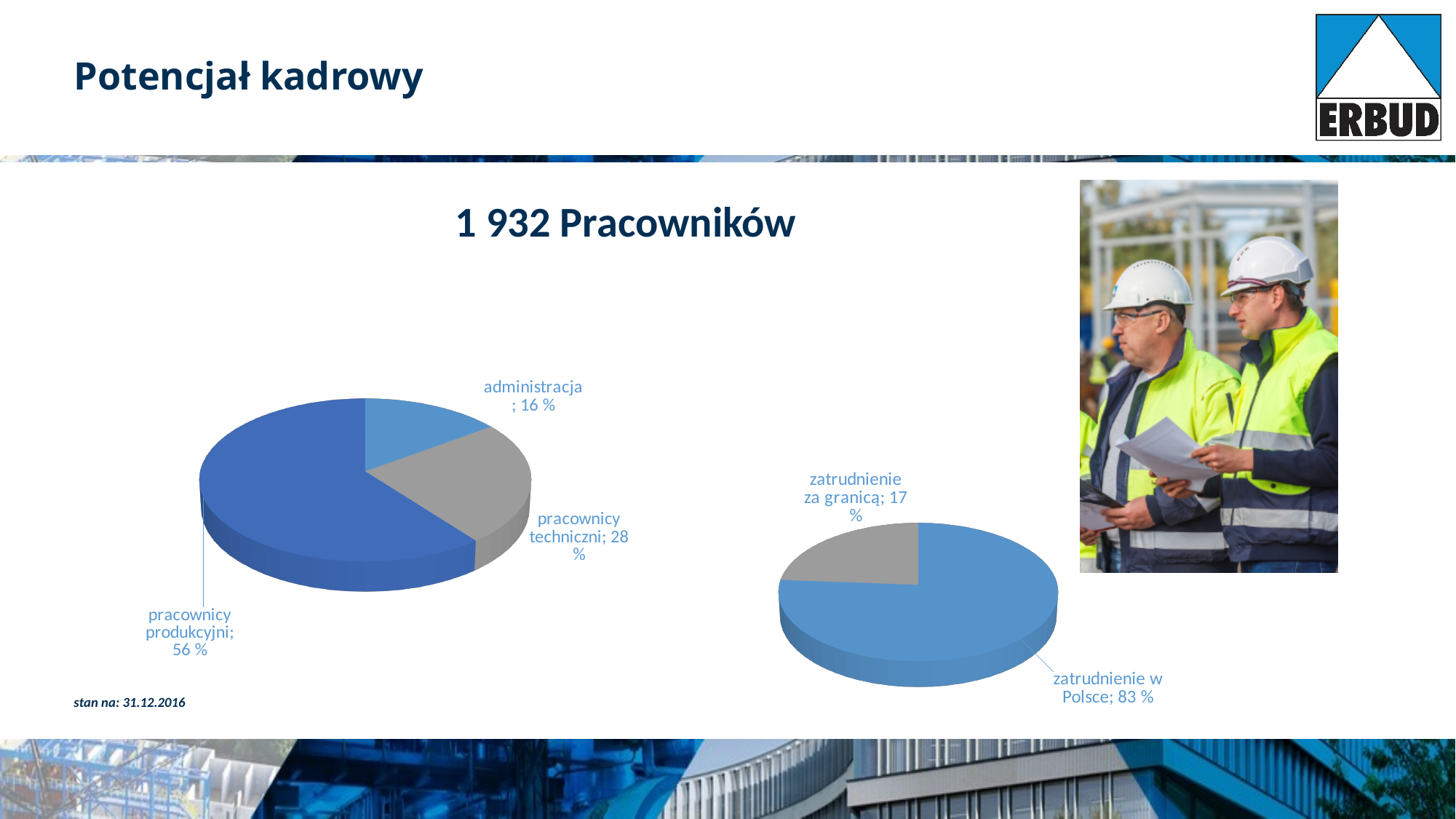
On the right pie chart, what share is shown for zatrudnienie w Polsce? 83 % On the right pie chart, what share is shown for zatrudnienie za granicą? 17 % On the left pie chart, which category has the smallest slice? administracja On the left pie chart, what share is shown for administracja? 16 % On the left pie chart, which category has the largest slice? pracownicy produkcyjni On the left pie chart, how many slices are there? 3 On the left pie chart, what share is shown for pracownicy produkcyjni? 56 % What type of chart is the right chart on the slide? pie chart On the left pie chart, what share is shown for pracownicy techniczni? 28 % On the right pie chart, what is the difference in percentage points between zatrudnienie w Polsce and zatrudnienie za granicą? 66 On the left pie chart, what is the difference in percentage points between pracownicy produkcyjni and pracownicy techniczni? 28 On the right pie chart, which is larger: zatrudnienie w Polsce or zatrudnienie za granicą? zatrudnienie w Polsce